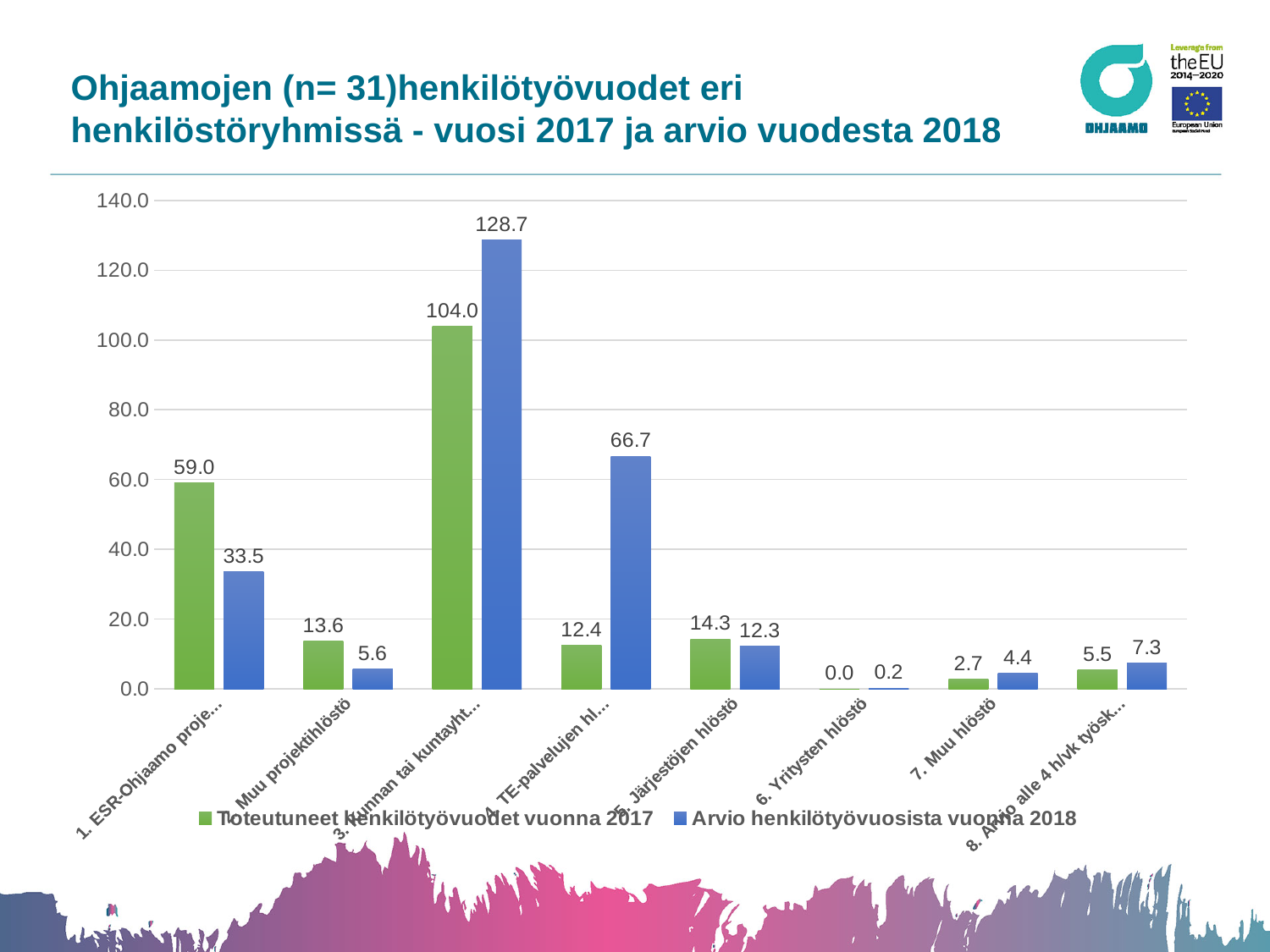
What kind of chart is shown on the slide? Bar chart What is the value of the 2018 estimate series (Arvio henkilötyövuosista vuonna 2018) for category 5, Järjestöjen hlöstö? 12.3 What is the value of the 2017 series (Toteutuneet henkilötyövuodet vuonna 2017) for category 2, Muu projektihlöstö? 13.6 Which category has the highest value in the 2018 estimate series? 3. Kunnan tai kuntayht... What is the difference between the 2018 estimate and the 2017 value for category 3, Kunnan tai kuntayht...? 24.7 How many series does the legend list? 2 For category 1, ESR-Ohjaamo proje..., which is larger: the 2017 value or the 2018 estimate? The 2017 value (59.0) Which colour represents the series 'Arvio henkilötyövuosista vuonna 2018'? Blue What is the 2018 estimate value for category 7, Muu hlöstö? 4.4 How many categories are shown on the x axis? 8 Which category has the lowest value in the 2017 series? 6. Yritysten hlöstö Is the 2018 estimate for category 4, TE-palvelujen hl..., greater or less than 60.0? greater